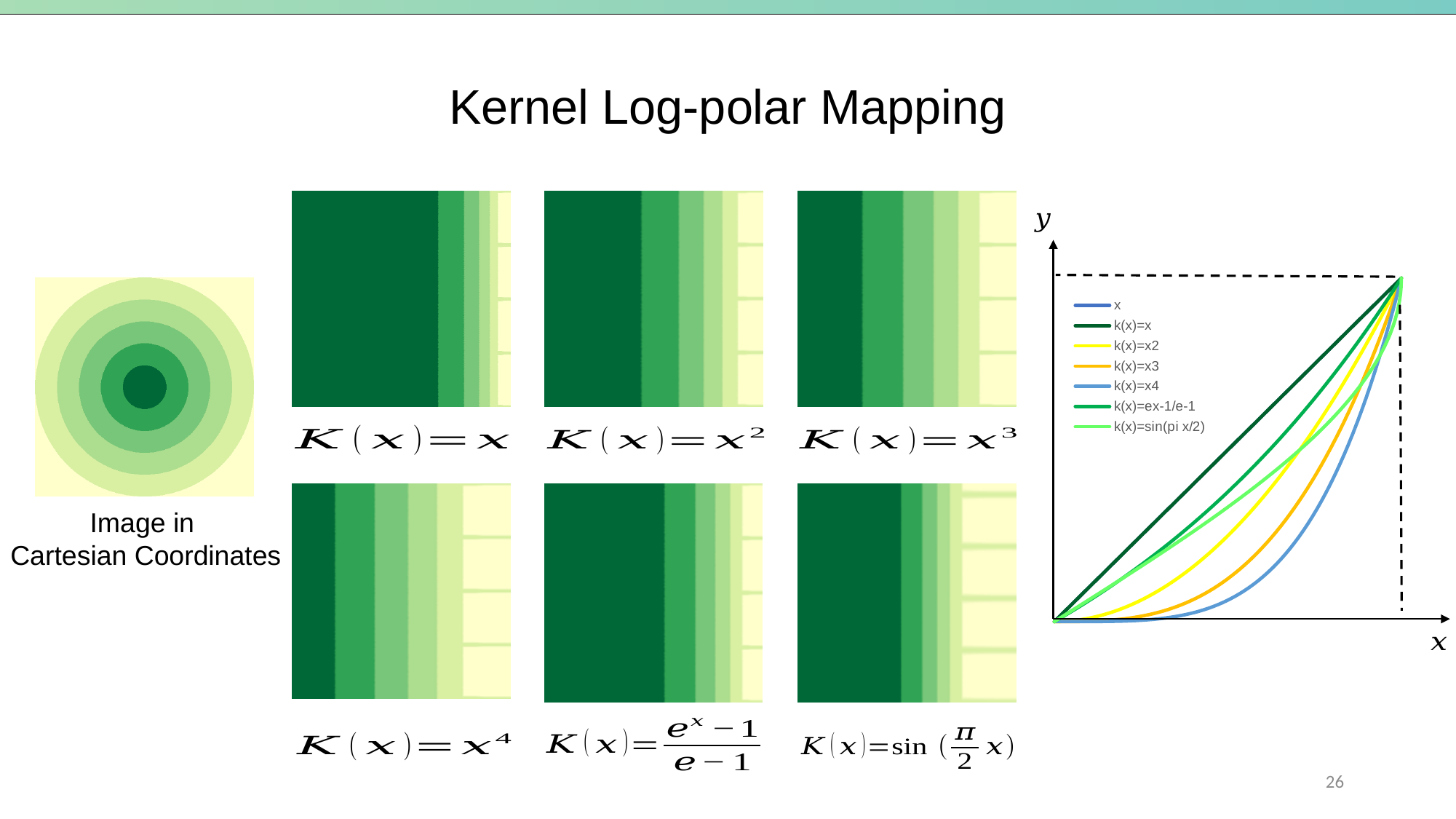
What kind of chart is shown on the right of the slide? line chart What label is on the horizontal axis of the line chart? x In the line chart, do the curves rise or fall as x increases? rise In the line chart, which series has the lowest value in the middle of the x range? k(x)=x4 In the line chart, which series has the highest value in the middle of the x range? k(x)=x In the line chart, at the middle of the x range, which is larger: k(x)=ex-1/e-1 or k(x)=x3? k(x)=ex-1/e-1 What colour is the k(x)=x4 line in the line chart? blue In the line chart, at the middle of the x range, which is larger: k(x)=x2 or k(x)=x3? k(x)=x2 In the line chart, at the middle of the x range, which is larger: k(x)=sin(pi x/2) or k(x)=x4? k(x)=sin(pi x/2) How many series does the legend of the line chart list? 7